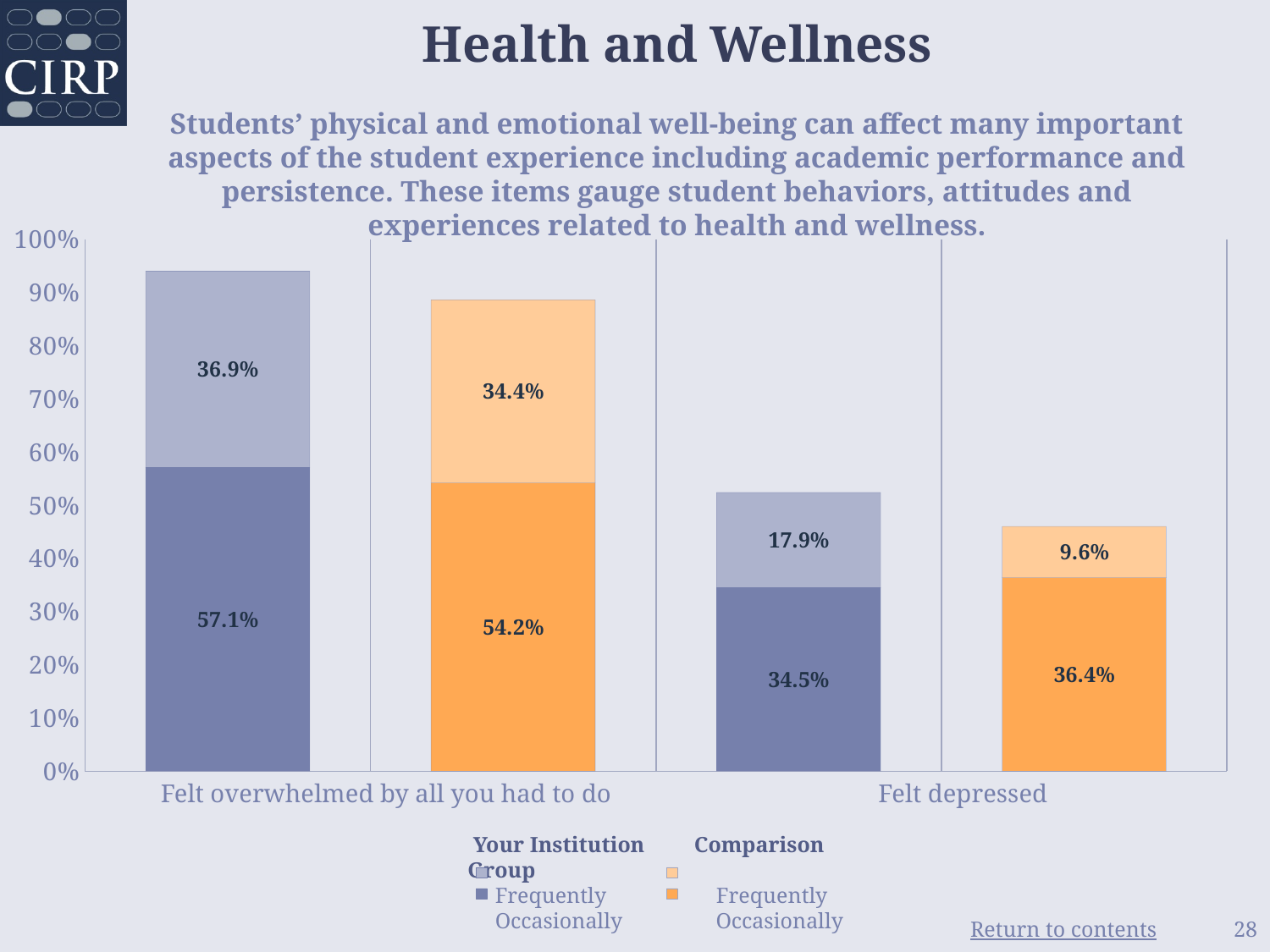
What is the total stacked percentage (frequently plus occasionally) for Your Institution on 'Felt overwhelmed by all you had to do'? 94.0% What is the difference between Your Institution and the Comparison Group for occasionally feeling depressed? 1.9% How many survey items (categories) are shown on the x axis? 2 For frequently feeling depressed, which is larger: Your Institution or the Comparison Group? Your Institution What type of chart is shown on the slide? Stacked bar chart What is the difference between Your Institution and the Comparison Group for frequently feeling overwhelmed by all they had to do? 2.5% What percentage of students in the Comparison Group reported frequently feeling depressed? 9.6% What percentage of students in the Comparison Group reported occasionally feeling depressed? 36.4% What is the total stacked percentage (frequently plus occasionally) for the Comparison Group on 'Felt depressed'? 46.0% What percentage of students at Your Institution reported frequently feeling overwhelmed by all they had to do? 36.9% Which stacked bar is the tallest overall? Your Institution, Felt overwhelmed by all you had to do What percentage of students at Your Institution reported occasionally feeling overwhelmed by all they had to do? 57.1%